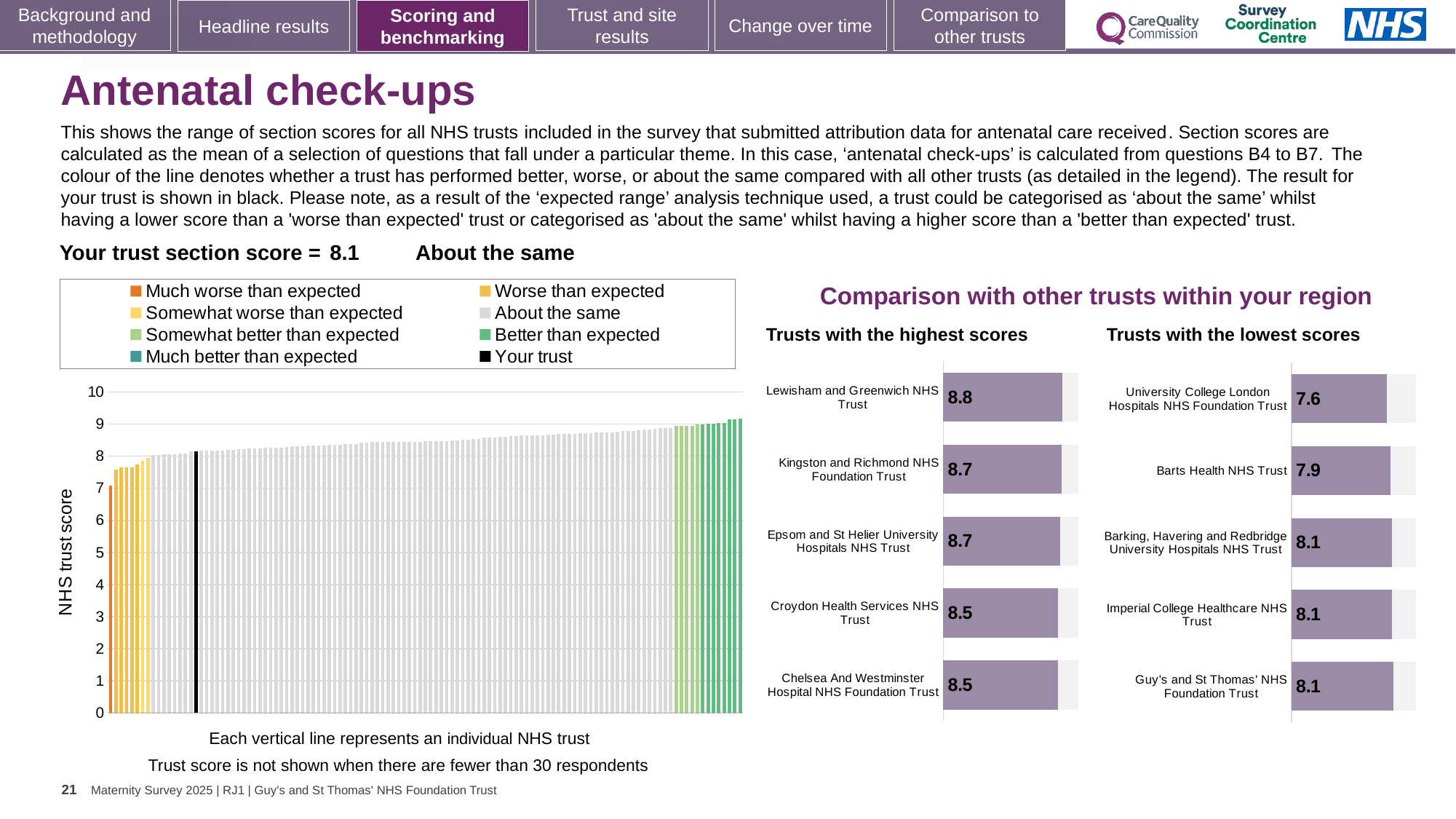
In the 'Trusts with the lowest scores' chart, what is the score for University College London Hospitals NHS Foundation Trust? 7.6 What kind of chart is the main chart showing NHS trust scores on the left? Bar chart In the 'Trusts with the highest scores' chart, what is the difference between the scores of Lewisham and Greenwich NHS Trust and Croydon Health Services NHS Trust? 0.3 In the 'Trusts with the highest scores' chart, what is the score for Lewisham and Greenwich NHS Trust? 8.8 In the main NHS trust score chart, is the value of the leftmost (orange) bar greater or less than 8? less In the main NHS trust score chart, do the bars rise or fall from left to right? Rise In the 'Trusts with the highest scores' chart, which trust has the highest score? Lewisham and Greenwich NHS Trust In the 'Trusts with the lowest scores' chart, which has the larger score: Barts Health NHS Trust or University College London Hospitals NHS Foundation Trust? Barts Health NHS Trust How many trusts are listed in the 'Trusts with the highest scores' chart? 5 In the 'Trusts with the lowest scores' chart, what is the score for Barts Health NHS Trust? 7.9 In the 'Trusts with the lowest scores' chart, which trust has the lowest score? University College London Hospitals NHS Foundation Trust How many entries does the legend of the main NHS trust score chart list? 8